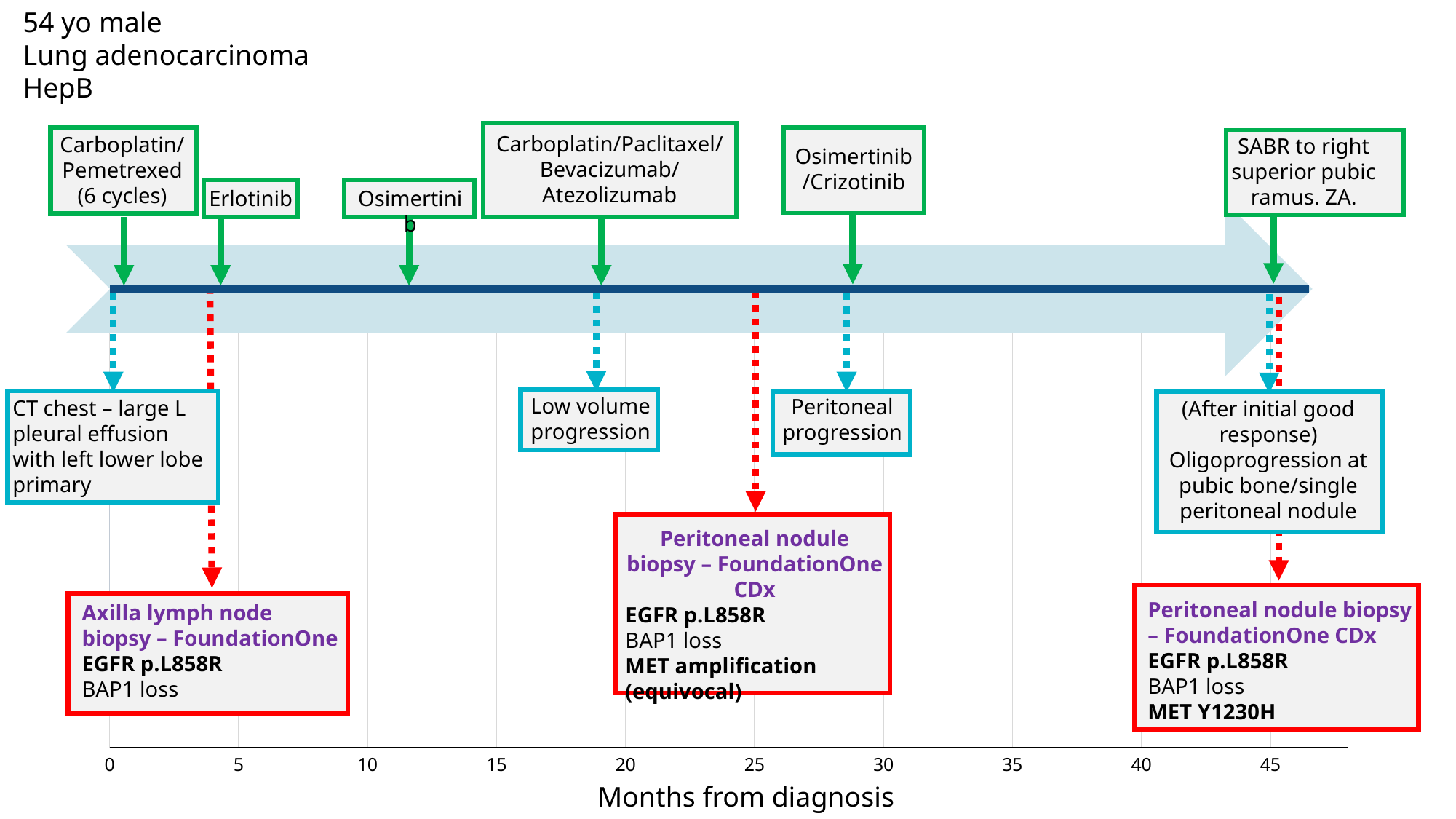
Is the start of Erlotinib greater or less than 5 months from diagnosis? less How many biopsy result boxes (red-outlined) are shown on the timeline? 3 Which treatment starts later on the timeline, Erlotinib or Osimertinib/Crizotinib? Osimertinib/Crizotinib At how many months from diagnosis is the SABR to right superior pubic ramus treatment placed? 45 Is the start of Carboplatin/Paclitaxel/Bevacizumab/Atezolizumab greater or less than 20 months from diagnosis? less At how many months from diagnosis is the peritoneal nodule biopsy with MET amplification (equivocal) placed? 25 Is the start of Osimertinib/Crizotinib greater or less than 30 months from diagnosis? less What is the highest tick value shown on the months axis? 45 How many treatment boxes (green-outlined) are shown above the timeline? 6 What is the label of the horizontal axis on the timeline? Months from diagnosis